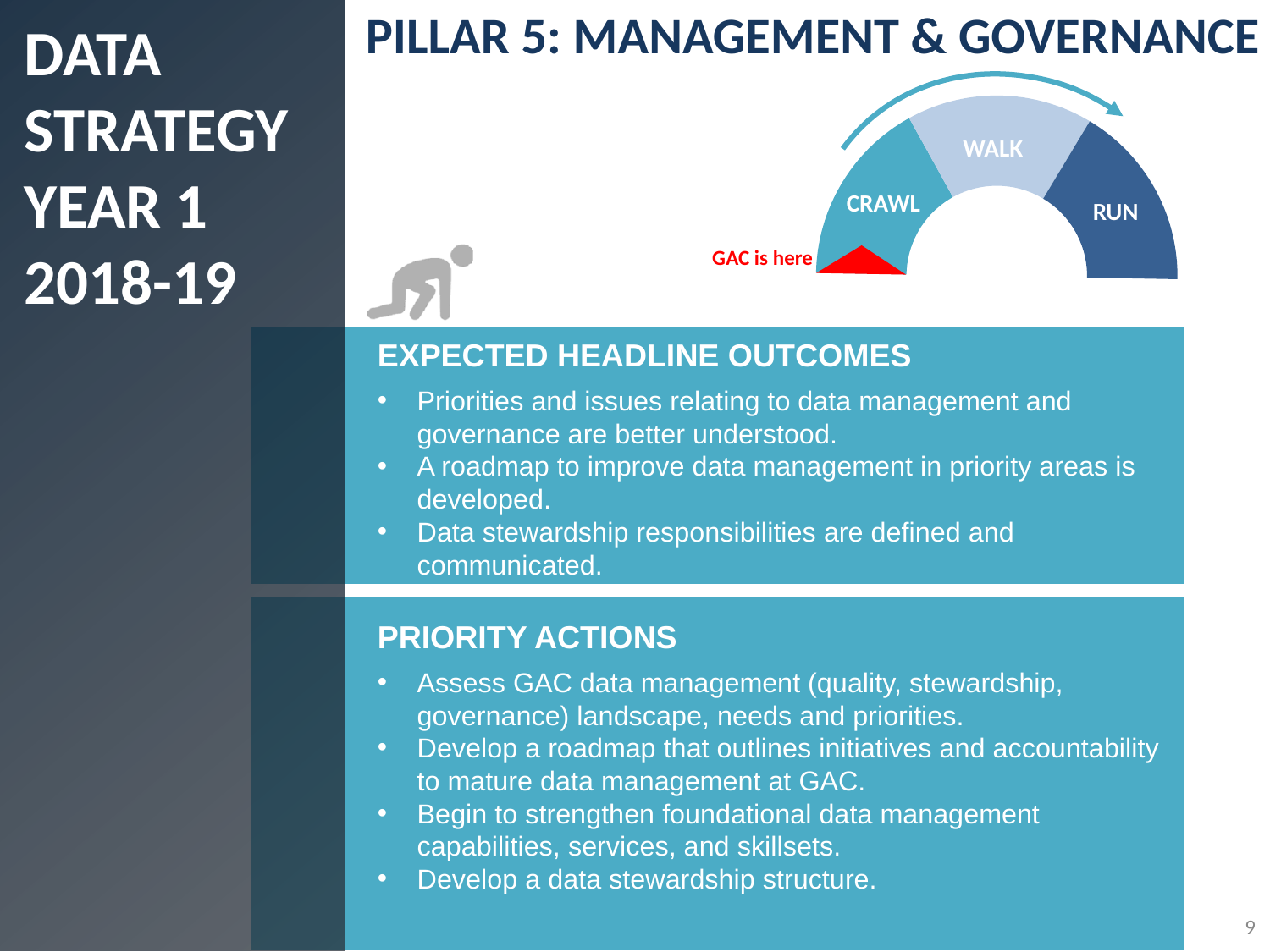
How many stages are shown on the gauge graphic? 3 What are the three stages labelled on the gauge, from left to right? CRAWL, WALK, RUN What kind of chart is the graphic at the top right of the slide? gauge chart Which stage of the gauge does the red 'GAC is here' indicator point to? CRAWL What colour is the 'GAC is here' indicator on the gauge? red Which stage is at the far right end of the gauge? RUN